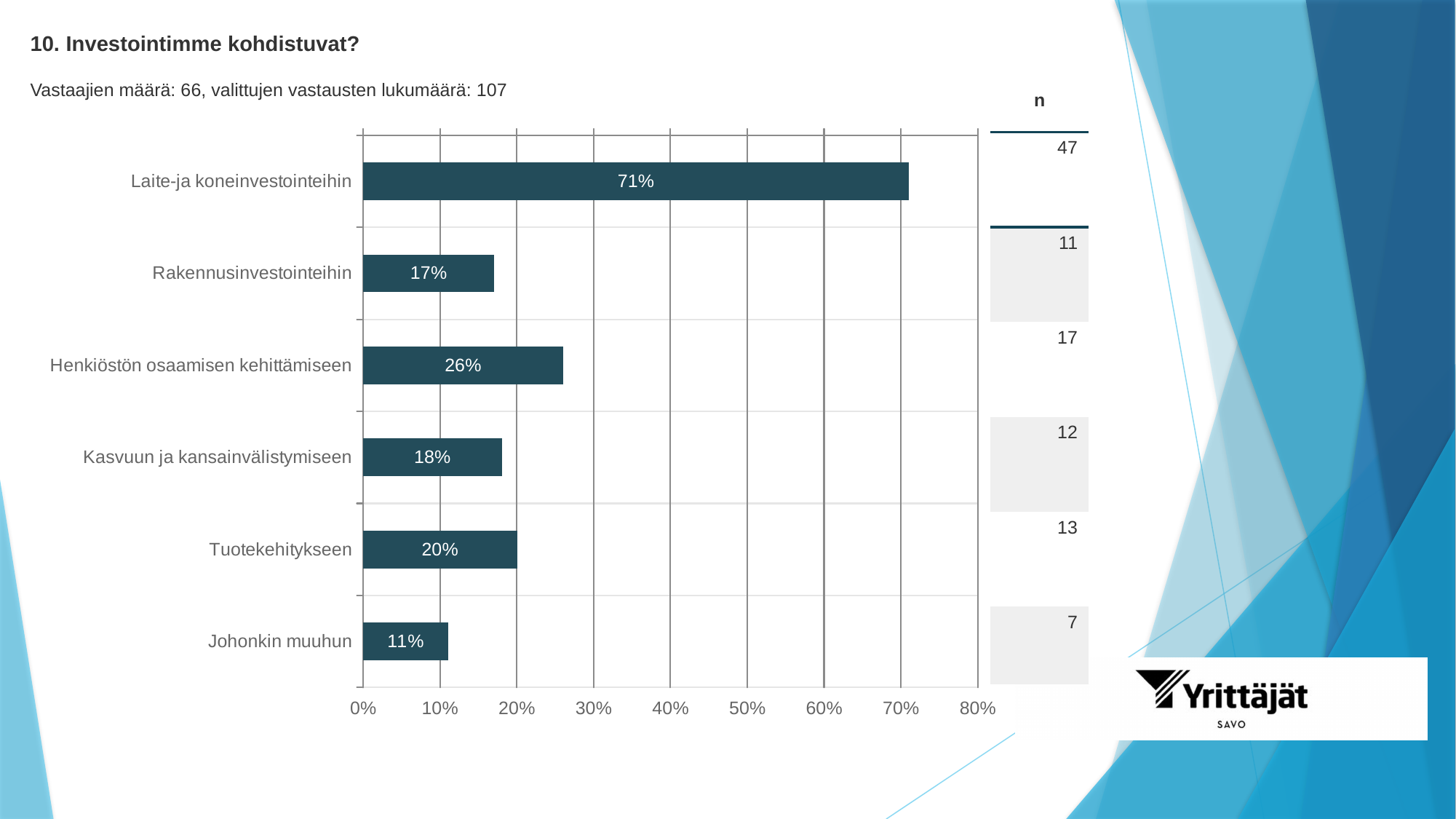
How many categories are shown in the chart? 6 What percentage is shown for Henkiöstön osaamisen kehittämiseen? 26% What is the difference in percentage points between Laite-ja koneinvestointeihin and Henkiöstön osaamisen kehittämiseen? 45 Is the value for Tuotekehitykseen greater or less than 30%? less What percentage is shown for Laite-ja koneinvestointeihin? 71% Which category has the lowest percentage? Johonkin muuhun What percentage is shown for Tuotekehitykseen? 20% What is the title of the chart? 10. Investointimme kohdistuvat? Which category has the highest percentage? Laite-ja koneinvestointeihin What is the n value listed for Rakennusinvestointeihin? 11 Which has a higher percentage, Rakennusinvestointeihin or Kasvuun ja kansainvälistymiseen? Kasvuun ja kansainvälistymiseen What kind of chart is shown on the slide? bar chart